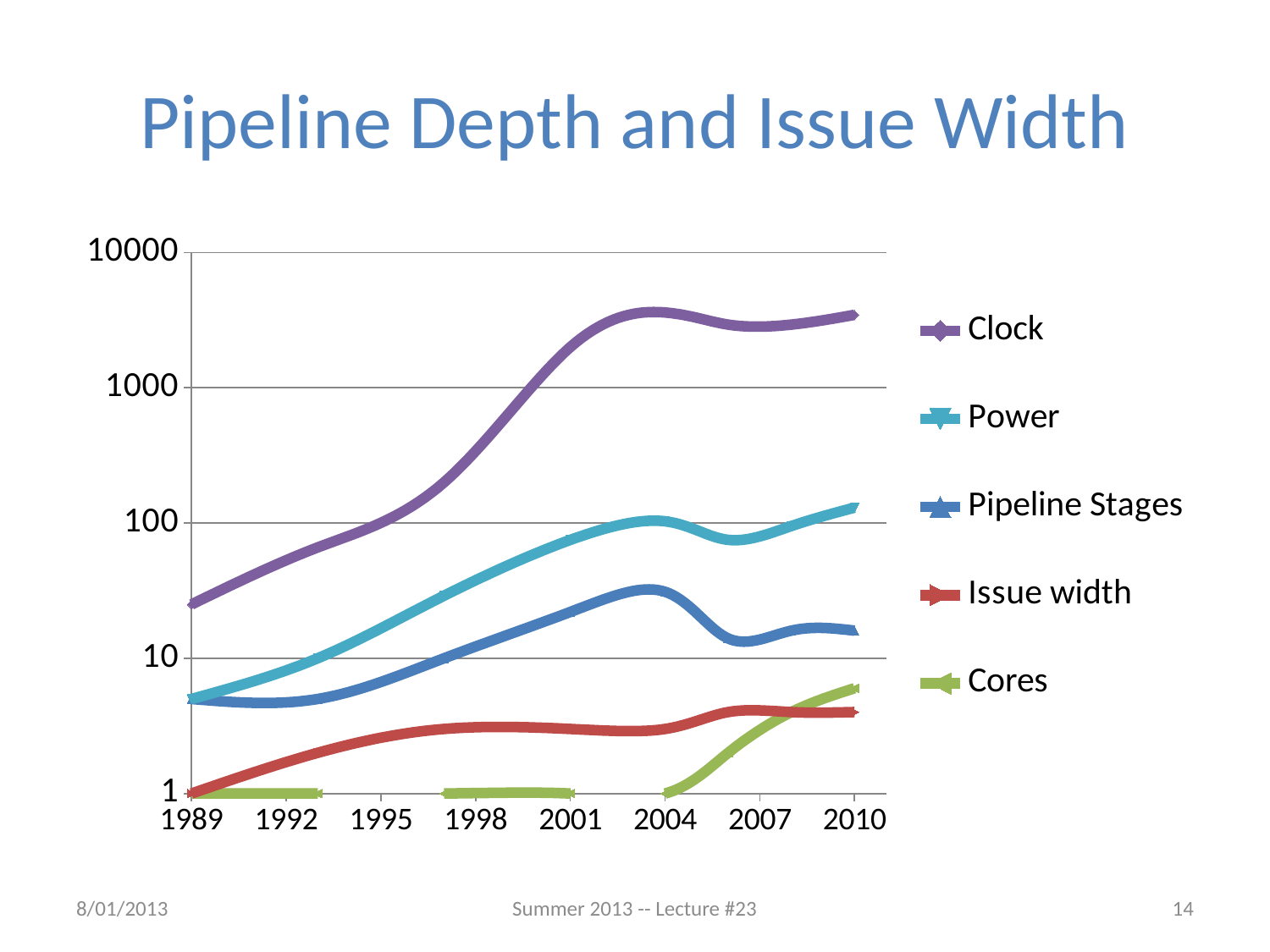
How many year labels are shown on the x axis? 8 What kind of chart is shown on the slide? line chart Is the value for Cores in 2010 greater or less than 10? less Does the Clock series rise or fall from 1989 to 2004? rise How many series does the legend list? 5 What is the value for Cores in 1989? 1 Which series has the highest value in 2010? Clock Is the value for Clock in 2010 greater or less than 1000? greater In 2010, which is larger, Cores or Issue width? Cores Is the value for Pipeline Stages in 2010 greater or less than 100? less What colour is the Clock line? purple Which series has the lowest value in 2010? Issue width